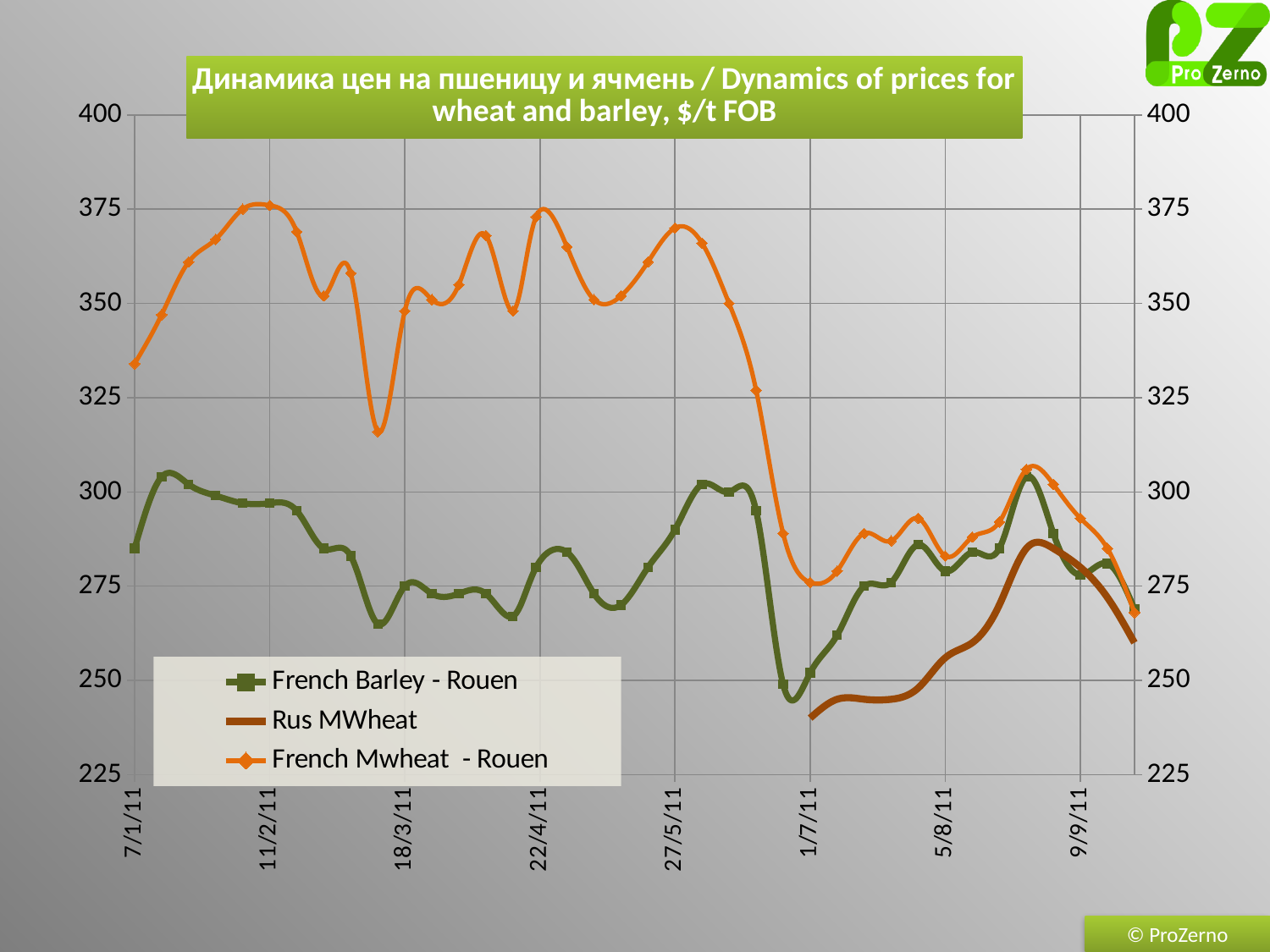
Does the French Mwheat - Rouen series rise or fall between 27/5/11 and 1/7/11? fall Is the value for French Mwheat - Rouen at 7/1/11 greater or less than 325? greater Is the value for Rus MWheat at 5/8/11 greater or less than 250? greater Is the value for French Mwheat - Rouen at 22/4/11 greater or less than 350? greater What kind of chart is shown on the slide? line chart How many series does the legend list? 3 At 7/1/11, which series has the higher value: French Mwheat - Rouen or French Barley - Rouen? French Mwheat - Rouen Which series is drawn in orange with diamond markers? French Mwheat - Rouen At 1/7/11, which series has the higher value: French Barley - Rouen or Rus MWheat? French Barley - Rouen